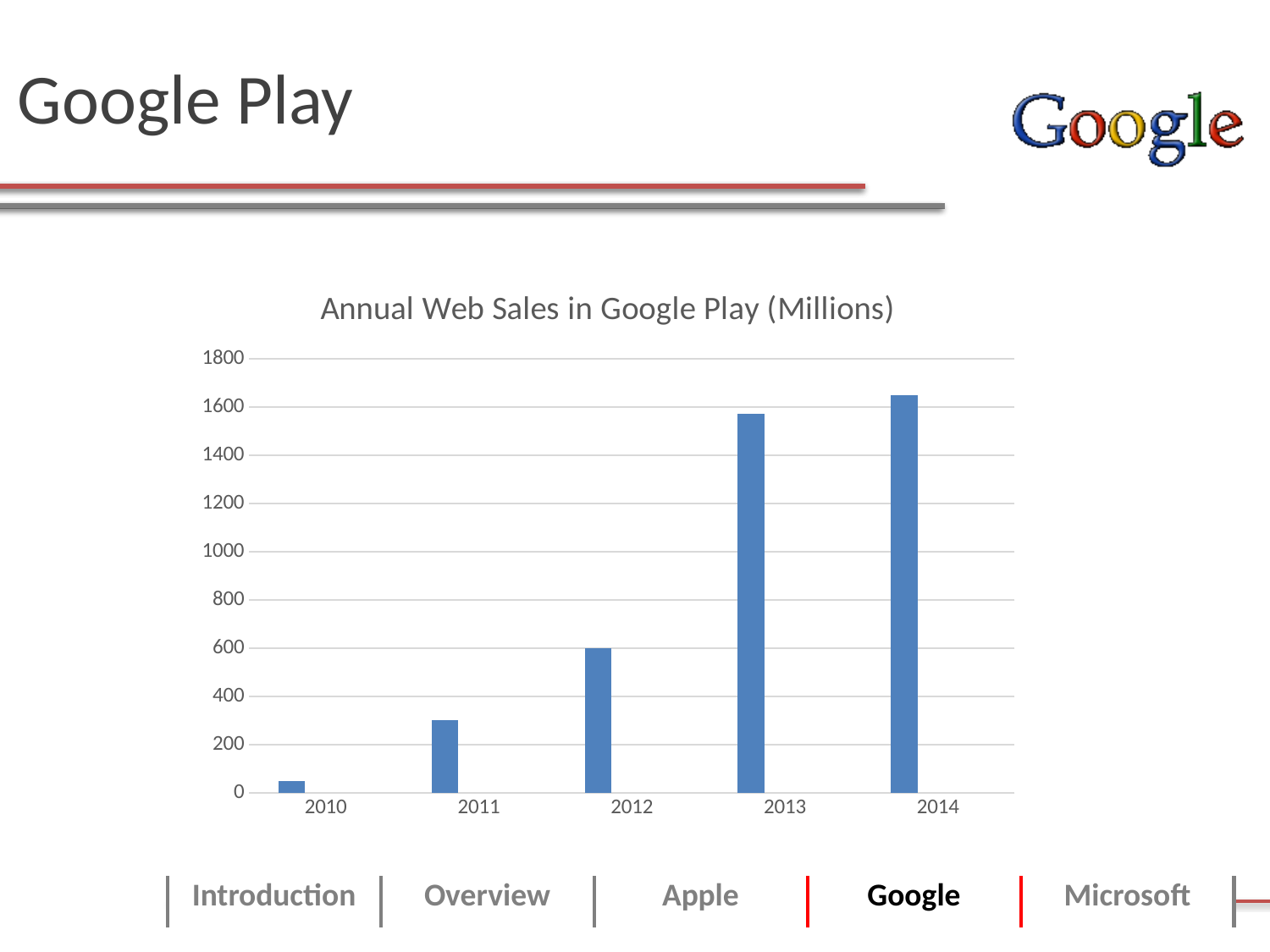
Is the value for 2014 greater or less than 1600? greater Which year has the lowest annual web sales in Google Play? 2010 How many years are shown on the x axis of the chart? 5 Is the value for 2013 greater or less than 1400? greater What kind of chart is shown on the slide? bar chart What is the title of the chart? Annual Web Sales in Google Play (Millions) Is the value for 2011 greater or less than 400? less Which year has the highest annual web sales in Google Play? 2014 Do the annual web sales rise or fall from 2010 to 2014? rise What is the annual web sales value for 2012? 600 Which year has larger annual web sales, 2012 or 2013? 2013